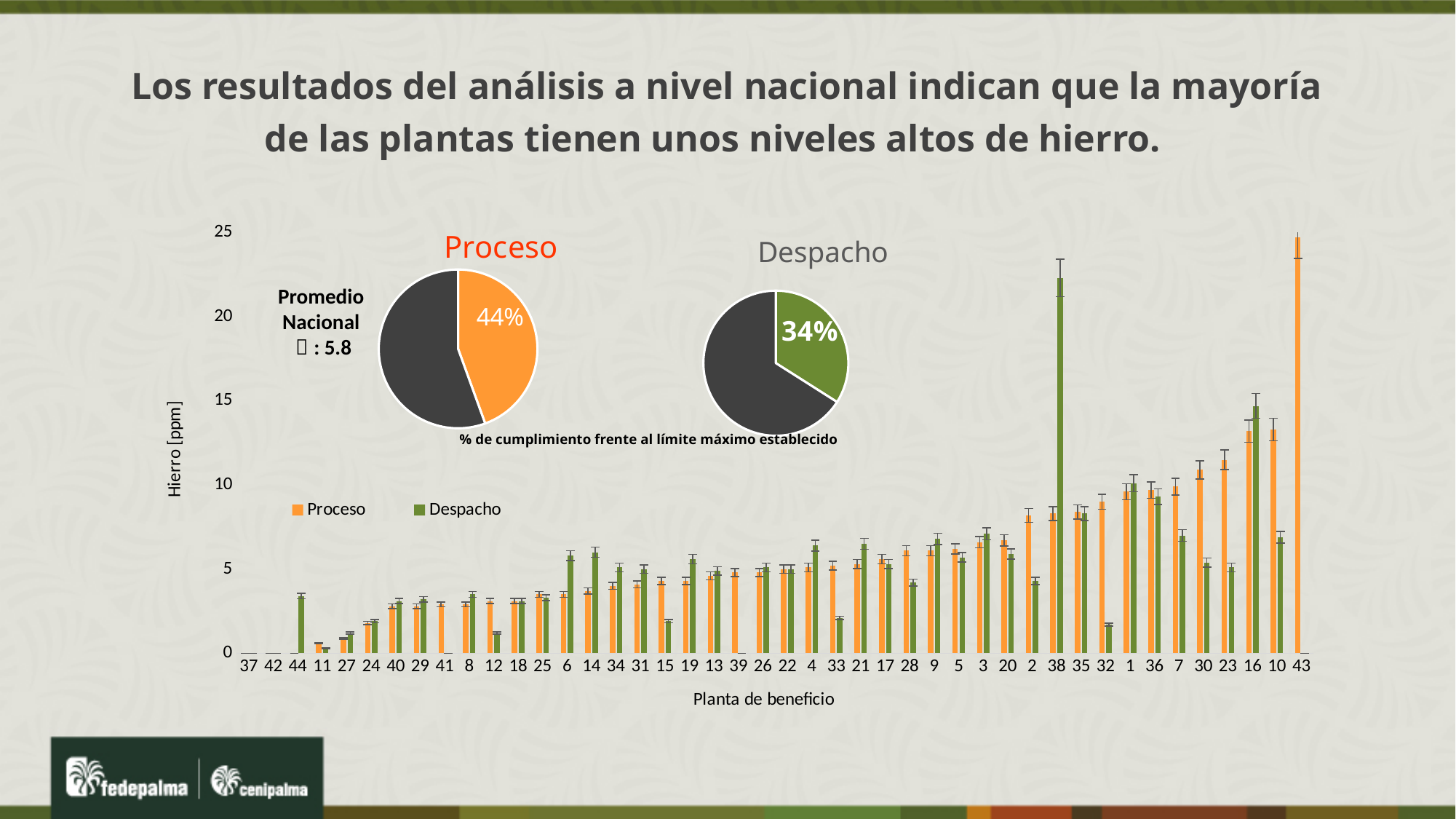
What is the difference in percentage points between the Proceso pie's 44% slice and the Despacho pie's 34% slice? 10 percentage points In the bar chart of Hierro [ppm] by Planta de beneficio, how many plantas are shown on the x axis? 44 What kind of chart is the large chart of Hierro [ppm] by Planta de beneficio? Bar chart In the Proceso pie chart, what percentage is shown for the highlighted (orange) slice? 44% Comparing the two pie charts, which has the larger highlighted share, Proceso or Despacho? Proceso In the Despacho pie chart, what percentage is shown for the highlighted (green) slice? 34% In the bar chart, do the Proceso values generally rise or fall from left to right along the x axis? rise In the bar chart, which planta has the highest Proceso value? 43 In the bar chart, which planta has the highest Despacho value? 38 In the bar chart of Hierro [ppm] by Planta de beneficio, how many series does the legend list? 2 In the bar chart, is the Proceso value for planta 43 greater or less than 20? greater In the bar chart, is the Despacho value for planta 32 greater or less than 5? less